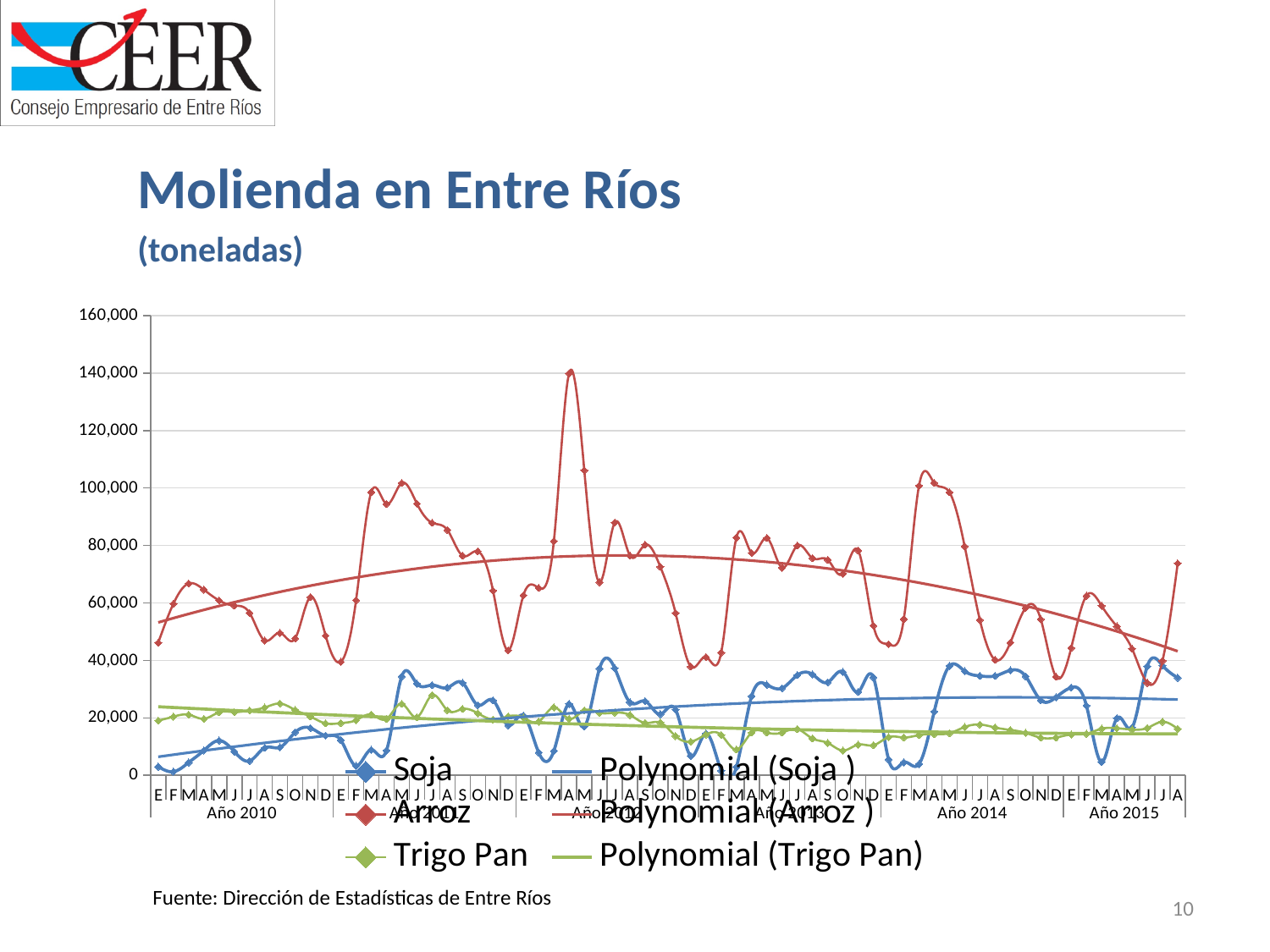
What is the maximum value shown on the vertical axis of the chart? 160,000 What kind of chart is shown on the slide? line chart Is the highest value of the Soja series greater or less than 60,000? less Is the peak value of the Arroz series greater or less than 120,000? greater How many years are labelled along the x axis of the chart? 6 Which series is generally higher across the chart, Arroz or Soja? Arroz Which series reaches the highest value in the chart? Arroz How many entries does the chart legend list? 6 What is the title of the chart? Molienda en Entre Ríos (toneladas) How many data series (excluding the polynomial trendlines) are plotted in the chart? 3 Does the Polynomial (Trigo Pan) trendline rise or fall from left to right? fall Is the highest value of the Trigo Pan series greater or less than 40,000? less